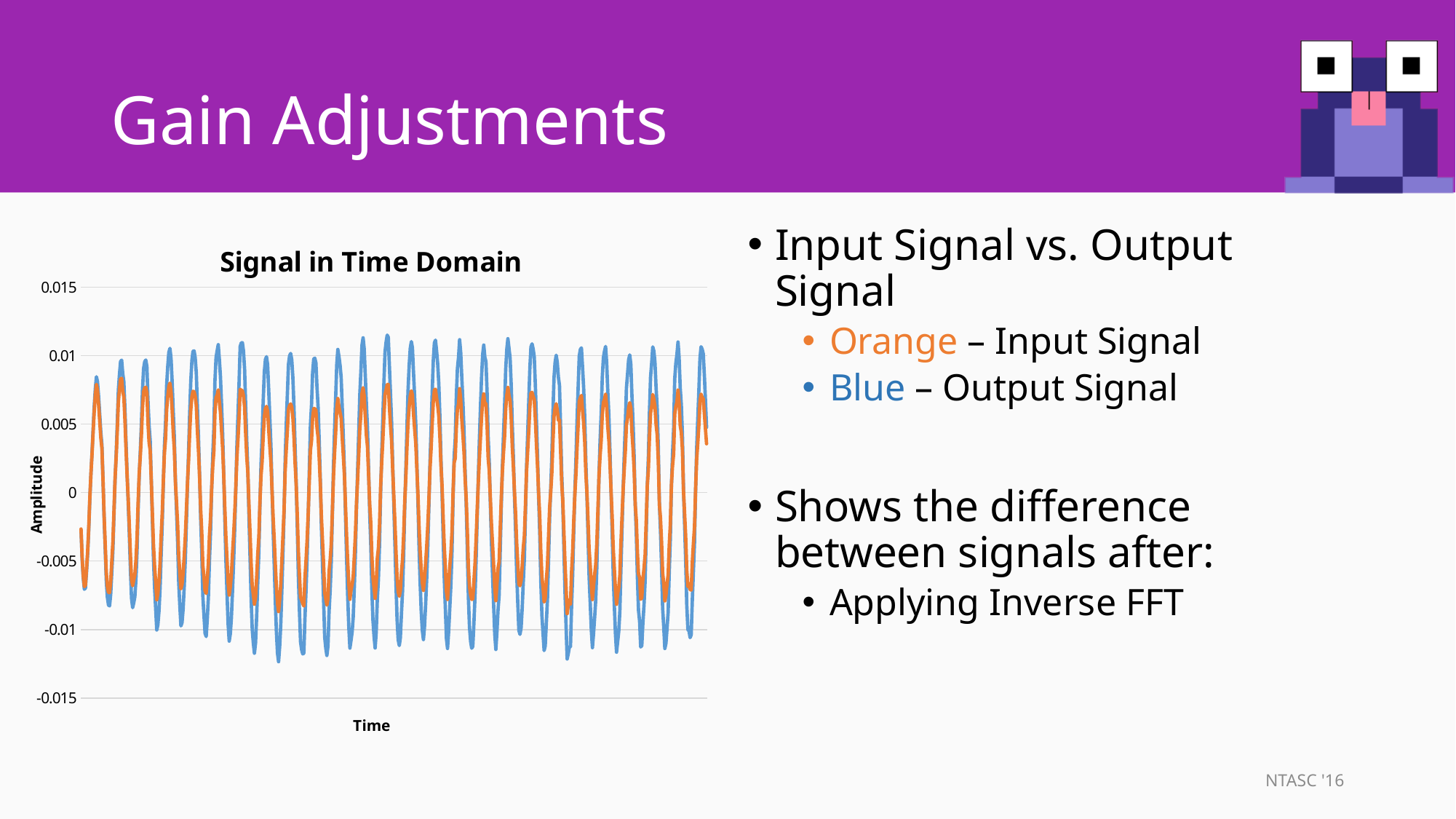
Is the peak amplitude of the blue output signal greater or less than 0.01? greater What is the highest value shown on the vertical axis? 0.015 What kind of chart is shown on the slide? line chart How many signal lines are plotted on the chart? 2 Which signal reaches higher peak amplitude, the orange (input) or the blue (output)? blue (output) Which signal has the smaller amplitude swing, the orange or the blue? orange What is the title of the chart? Signal in Time Domain What is the lowest value shown on the vertical axis? -0.015 What is the label on the vertical axis of the chart? Amplitude Is the lowest value of the orange input signal greater or less than -0.01? greater Is the peak amplitude of the orange input signal greater or less than 0.01? less